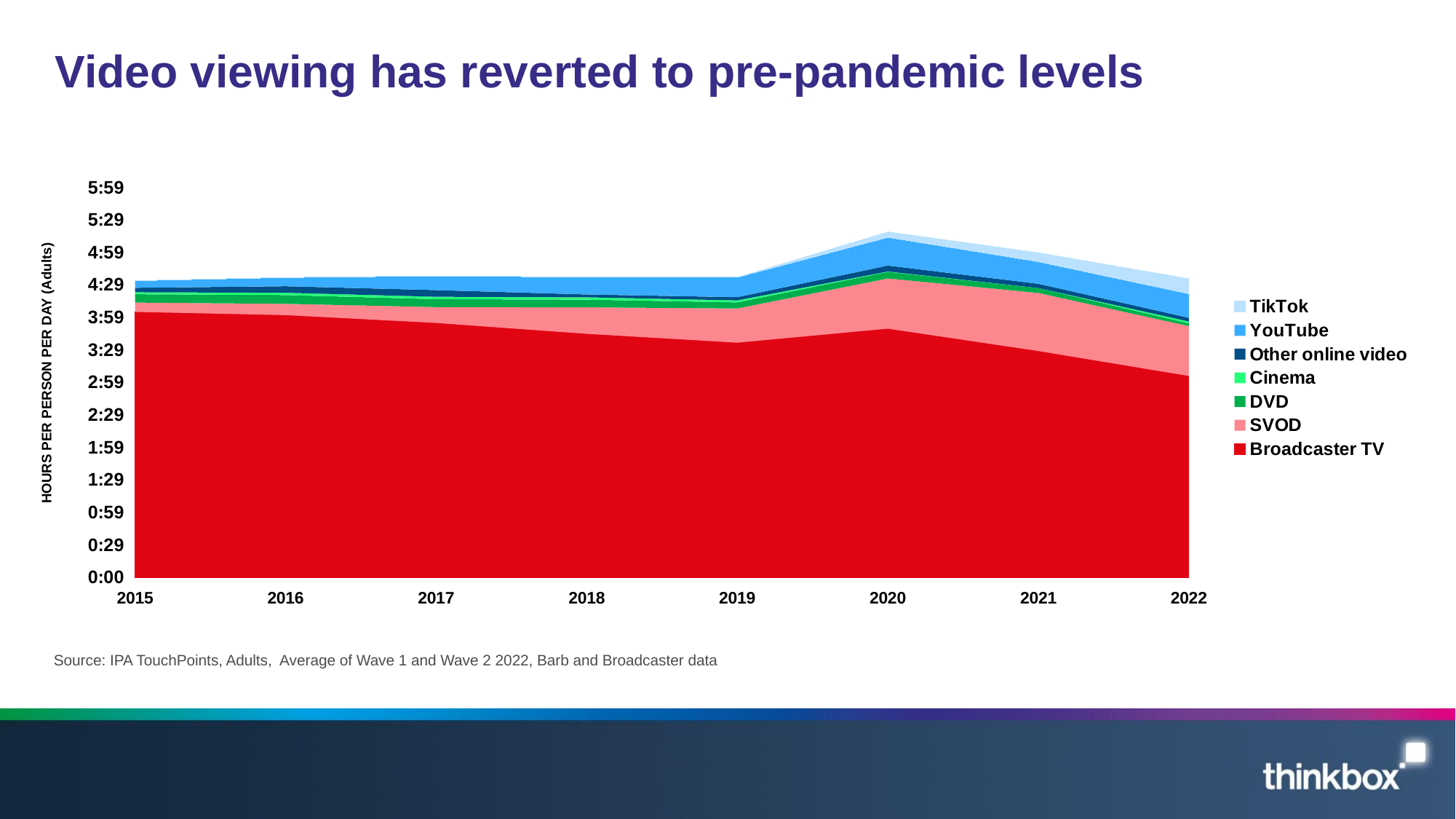
Is the total video viewing in 2020 greater or less than 4:59? greater What is the title of the slide? Video viewing has reverted to pre-pandemic levels What kind of chart is shown on the slide? Stacked area chart Which year has the highest total hours of video viewing per person per day? 2020 Does Broadcaster TV viewing rise or fall from 2020 to 2022? fall How many series does the legend list? 7 Which is larger, SVOD viewing in 2015 or SVOD viewing in 2022? 2022 Is the value for Broadcaster TV in 2015 greater or less than 3:29? greater Is the total video viewing in 2015 greater or less than 4:59? less How many years are shown along the x axis? 8 Which series accounts for the largest share of video viewing across all years? Broadcaster TV